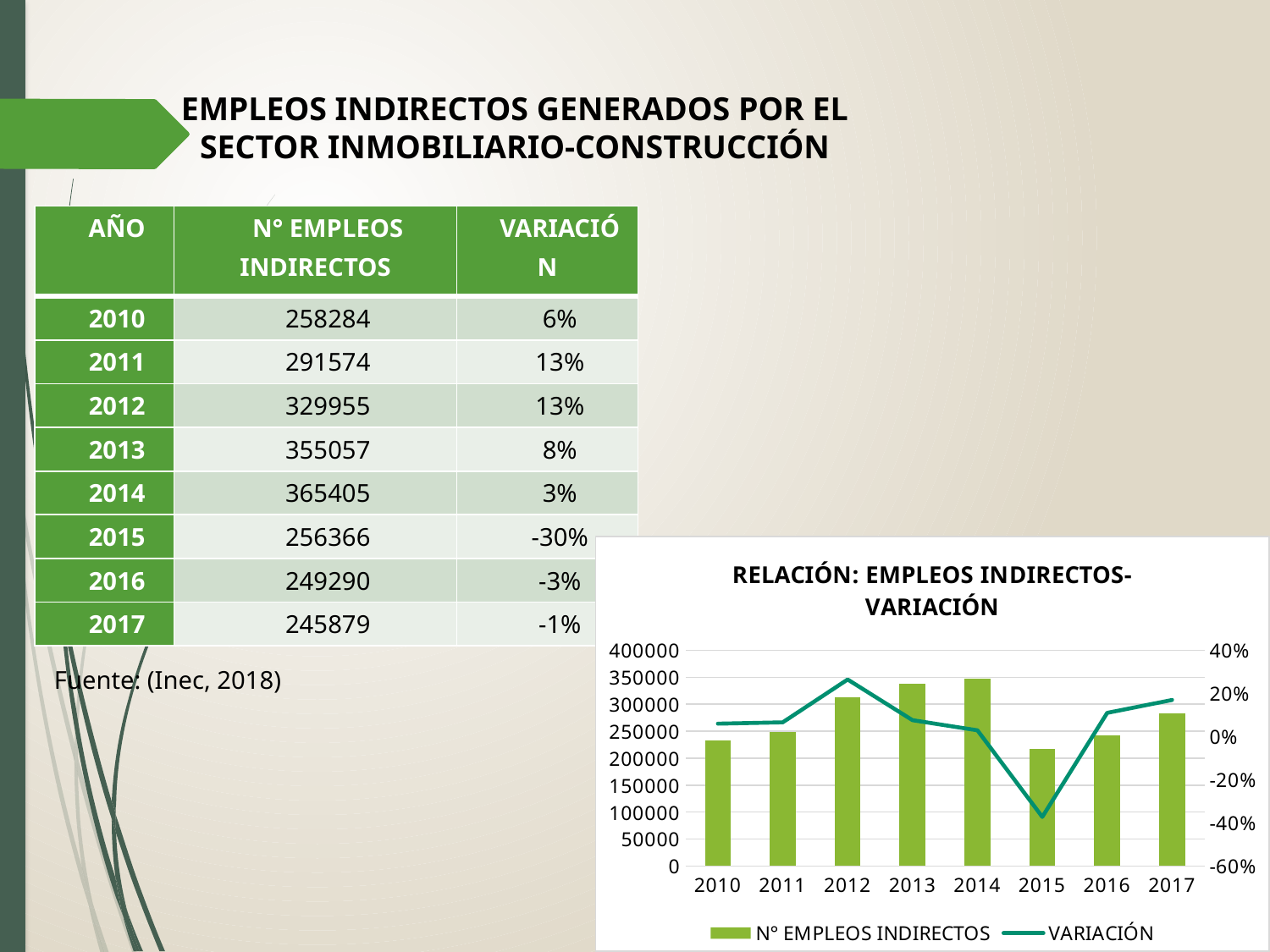
Which year has the tallest bar for N° EMPLEOS INDIRECTOS in the chart? 2014 Which bar is taller in the chart, 2012 or 2016? 2012 Which year has the shortest bar for N° EMPLEOS INDIRECTOS in the chart? 2015 According to the slide, what is the N° EMPLEOS INDIRECTOS for 2014? 365405 Is the N° EMPLEOS INDIRECTOS bar for 2014 greater or less than 300000? greater What kind of chart is shown on the slide? A bar chart combined with a line Is the VARIACIÓN value for 2015 greater or less than -20%? less How many series does the chart legend list? 2 According to the slide, what is the VARIACIÓN for 2015? -30% What is the title of the chart? RELACIÓN: EMPLEOS INDIRECTOS-VARIACIÓN What is the difference between the N° EMPLEOS INDIRECTOS for 2014 and 2013 shown on the slide? 10348 How many years are shown on the x axis of the chart? 8